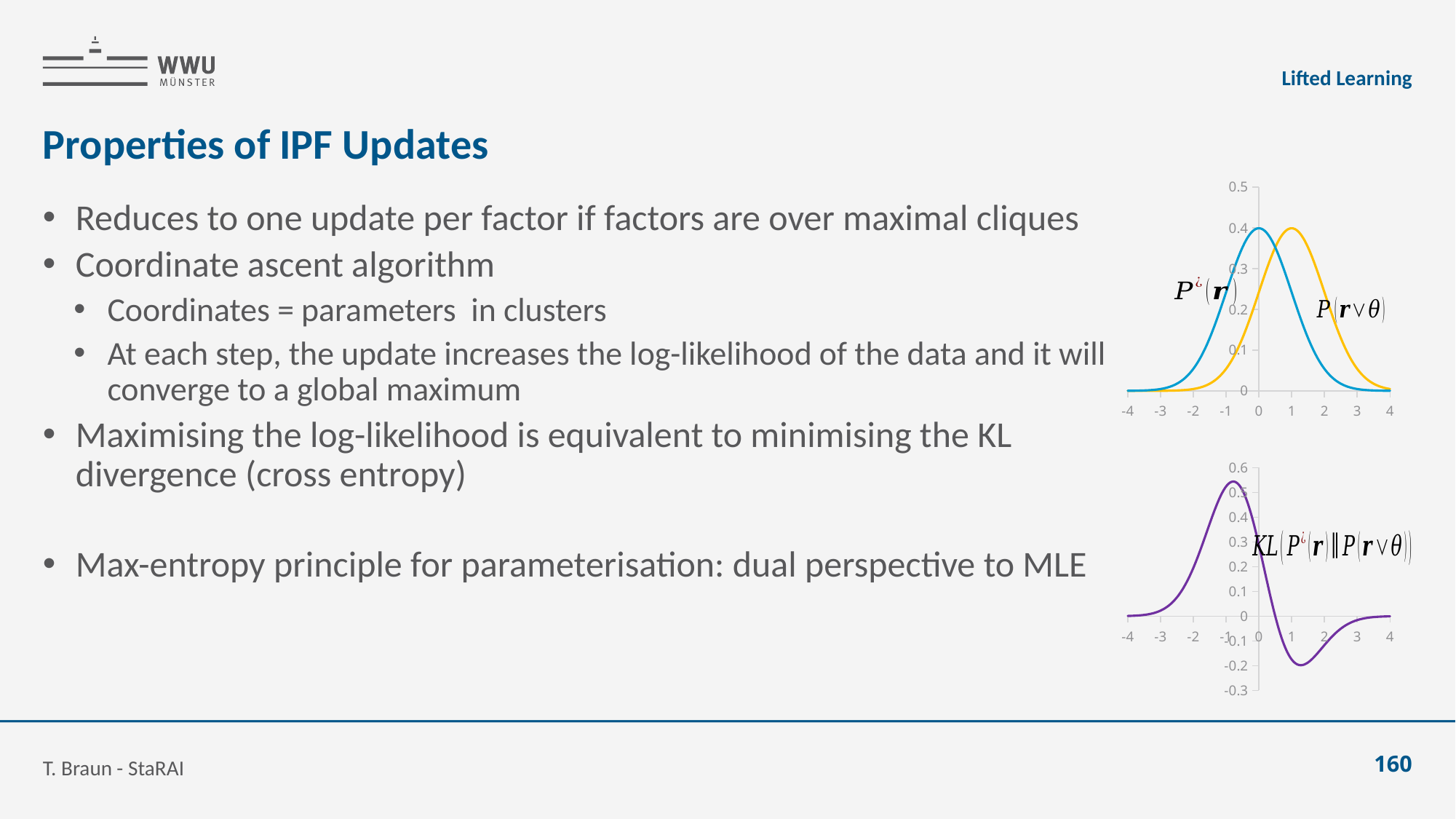
In the top chart, how many curves are plotted? 2 In the top chart, which curve has its peak further to the right, the blue one or the yellow one? the yellow one What is the lowest tick shown on the y axis of the bottom chart? -0.3 What is the highest tick shown on the y axis of the top chart? 0.5 In the top chart, at x = -2, which curve is higher, the blue one or the yellow one? the blue one In the top chart, is the value of the yellow curve at x = 4 greater or less than 0.1? less In the top chart, is the peak value of the blue curve greater or less than 0.3? greater In the bottom chart, does the purple curve rise or fall between x = -1 and x = 1? fall In the bottom chart, is the maximum value of the purple curve greater or less than 0.5? greater What kind of chart is the bottom chart on the right of the slide? line chart What kind of chart is the top chart on the right of the slide? line chart